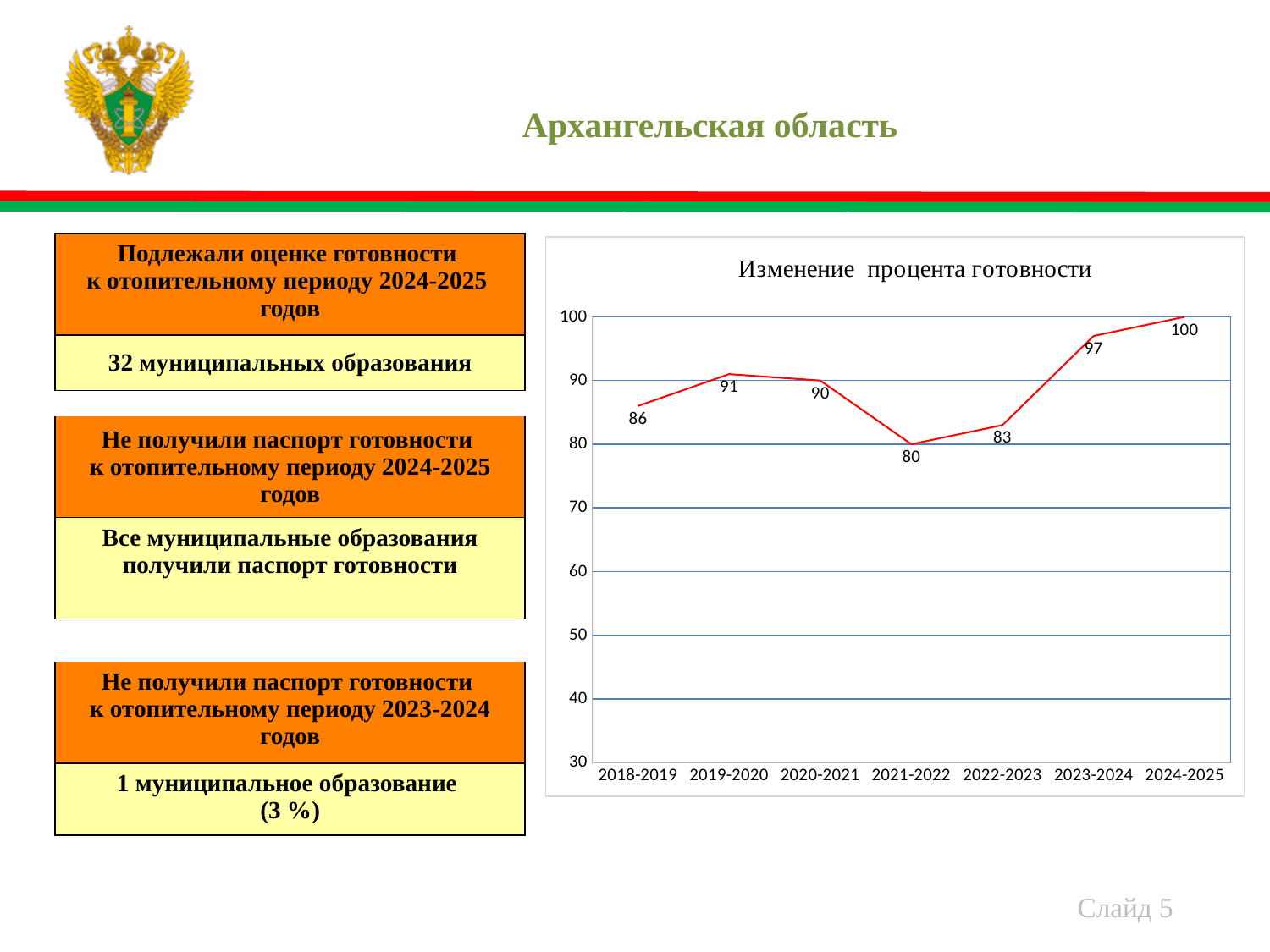
Which period has the highest value in the chart? 2024-2025 What is the title of the chart? Изменение процента готовности What is the value for 2021-2022 in the chart? 80 What is the value for 2023-2024 in the chart? 97 What is the difference between the values for 2024-2025 and 2021-2022? 20 How many periods are shown on the x axis of the chart? 7 Which is larger, the value for 2019-2020 or the value for 2022-2023? 2019-2020 Which period has the lowest value in the chart? 2021-2022 What is the value for 2018-2019 in the chart? 86 Is the value for 2022-2023 greater or less than 90? less What is the value for 2024-2025 in the chart? 100 What kind of chart is shown on the slide? line chart